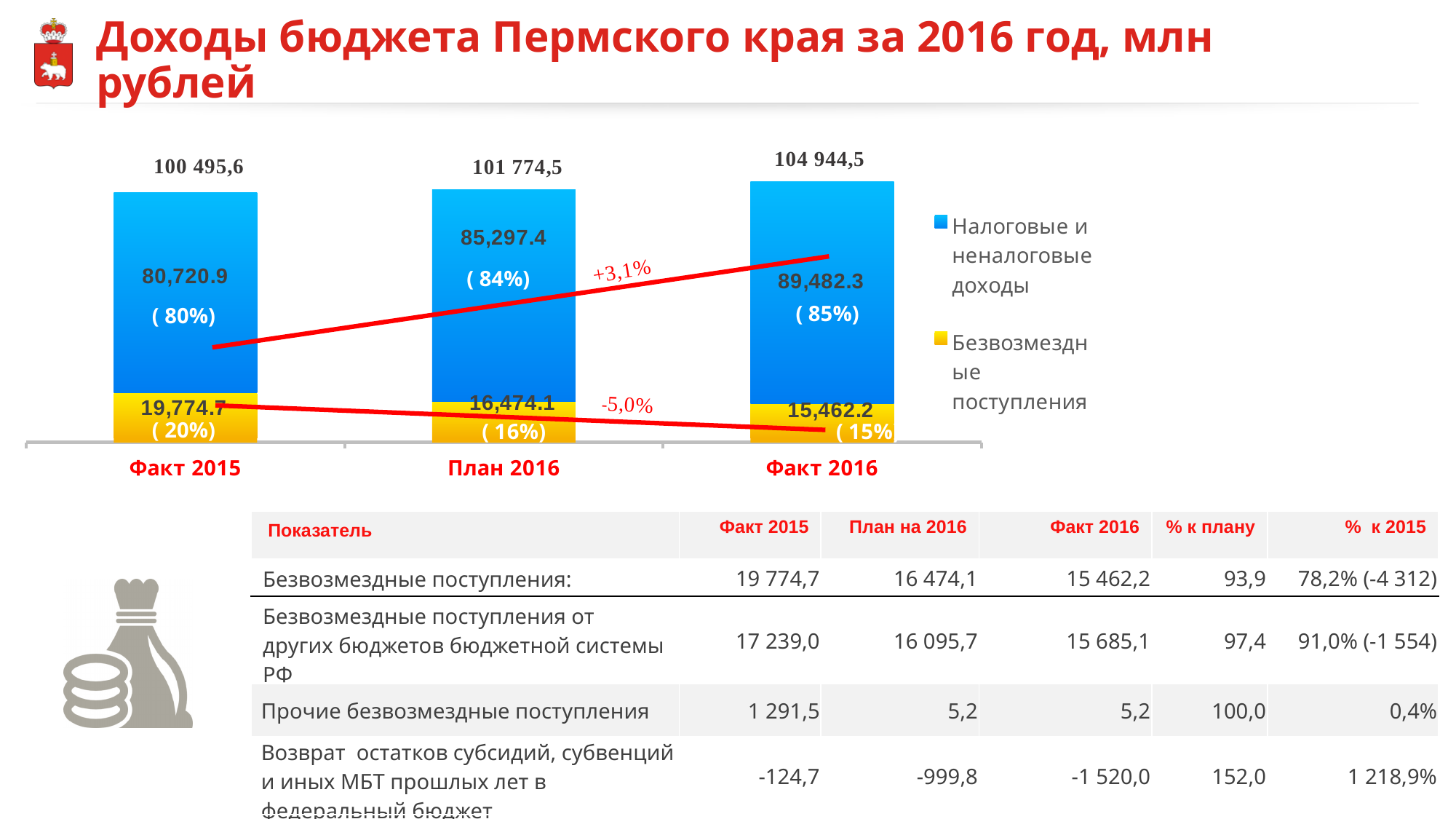
Does the value of Безвозмездные поступления rise or fall from Факт 2015 to Факт 2016? fall What is the value of Безвозмездные поступления for План 2016? 16,474.1 How many series does the chart legend list? 2 Which category has the lowest value for Безвозмездные поступления? Факт 2016 What is the value of Налоговые и неналоговые доходы for Факт 2015? 80,720.9 What kind of chart is shown on the slide? stacked bar chart Is the value of Безвозмездные поступления larger for Факт 2015 or for Факт 2016? Факт 2015 How many categories are shown on the x axis of the chart? 3 What is the total shown above the bar for Факт 2016? 104 944,5 What percentage share of the Факт 2015 bar is Безвозмездные поступления? 20% What is the value of Налоговые и неналоговые доходы for Факт 2016? 89,482.3 Which category has the highest value for Налоговые и неналоговые доходы? Факт 2016